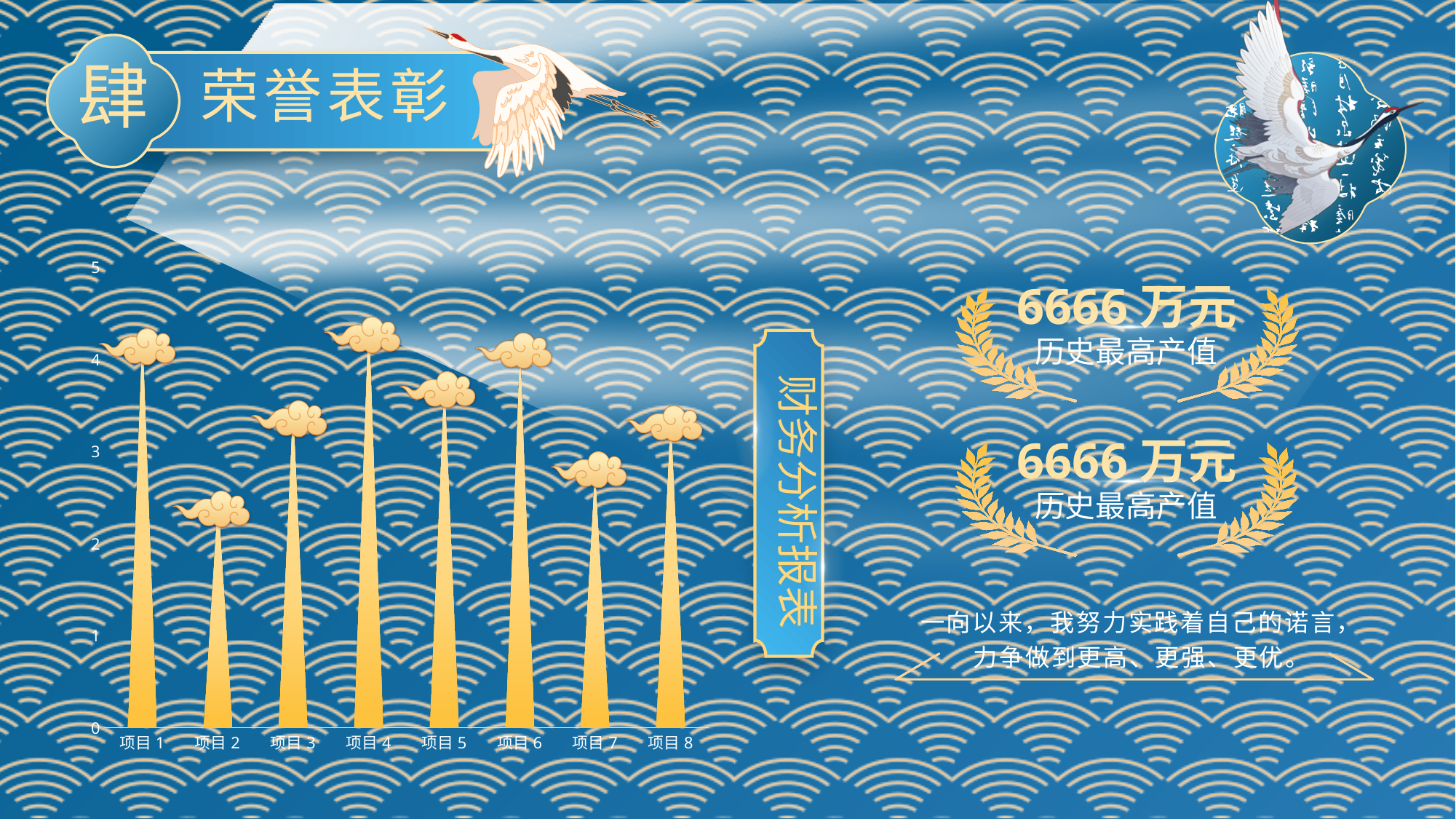
Which is larger, the value for 项目 4 or the value for 项目 7? 项目 4 Is the value for 项目 2 greater or less than 3? less Which category has the lowest bar in the chart? 项目 2 What is the label of the first category on the x axis of the chart? 项目 1 Which is larger, the value for 项目 1 or the value for 项目 2? 项目 1 Is the value for 项目 7 greater or less than 3? less Is the value for 项目 1 greater or less than 3? greater What kind of chart is shown on the slide? bar chart What is the highest value shown on the chart's y axis? 5 How many categories are plotted on the x axis of the chart? 8